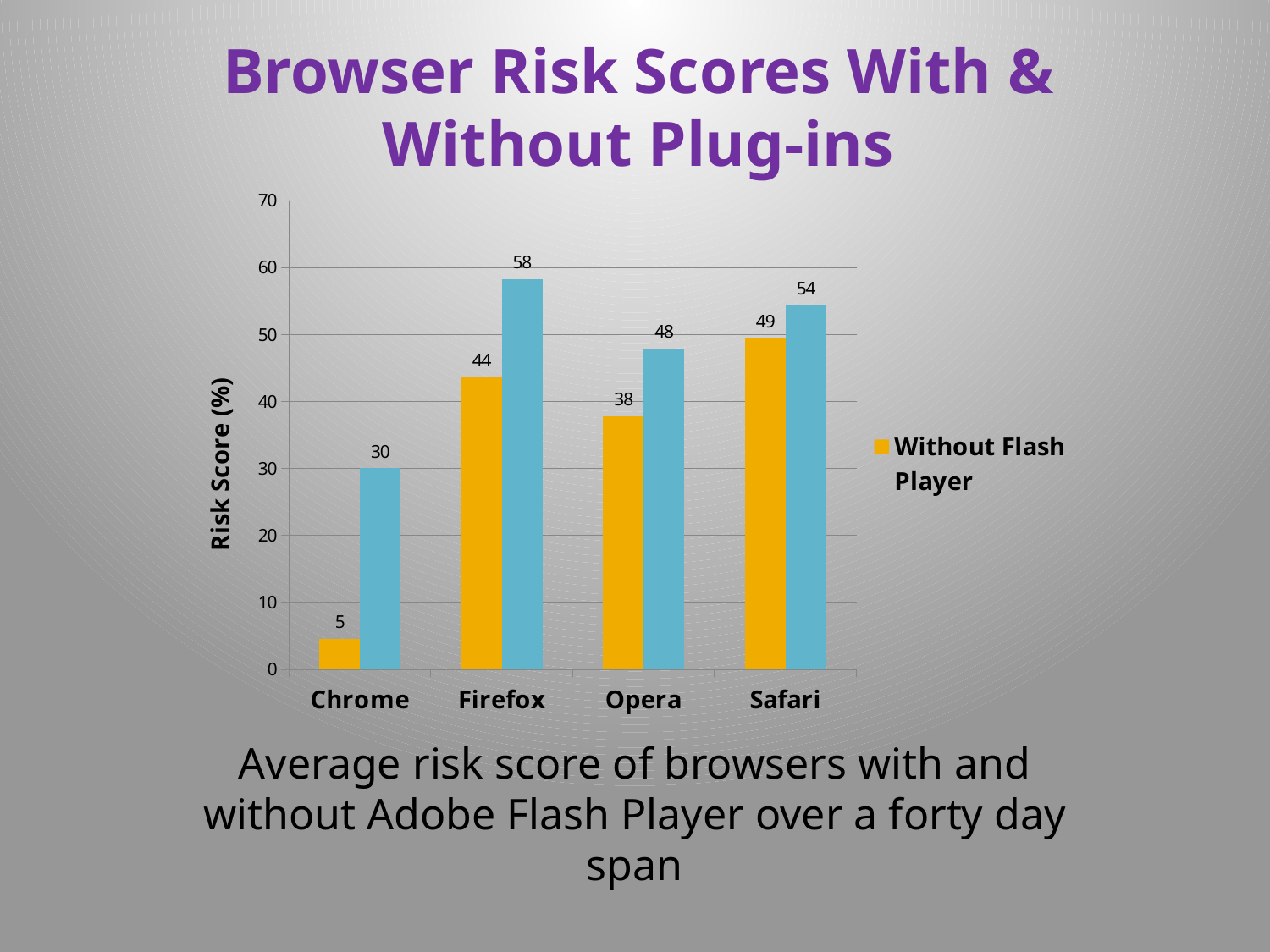
What is the Without Flash Player risk score for Chrome? 5 What kind of chart is shown on the slide? bar chart What is the Without Flash Player risk score for Safari? 49 How many series does the legend list? 1 What value is labelled on the blue bar for Firefox? 58 What is the difference between the blue bar and the Without Flash Player bar for Firefox? 14 How many browsers are shown on the x axis? 4 Which has a higher Without Flash Player risk score, Opera or Safari? Safari Which browser has the highest Without Flash Player risk score? Safari Which browser has the lowest Without Flash Player risk score? Chrome Is the value of the blue bar for Chrome greater or less than 20? greater What is the title of the vertical axis? Risk Score (%)